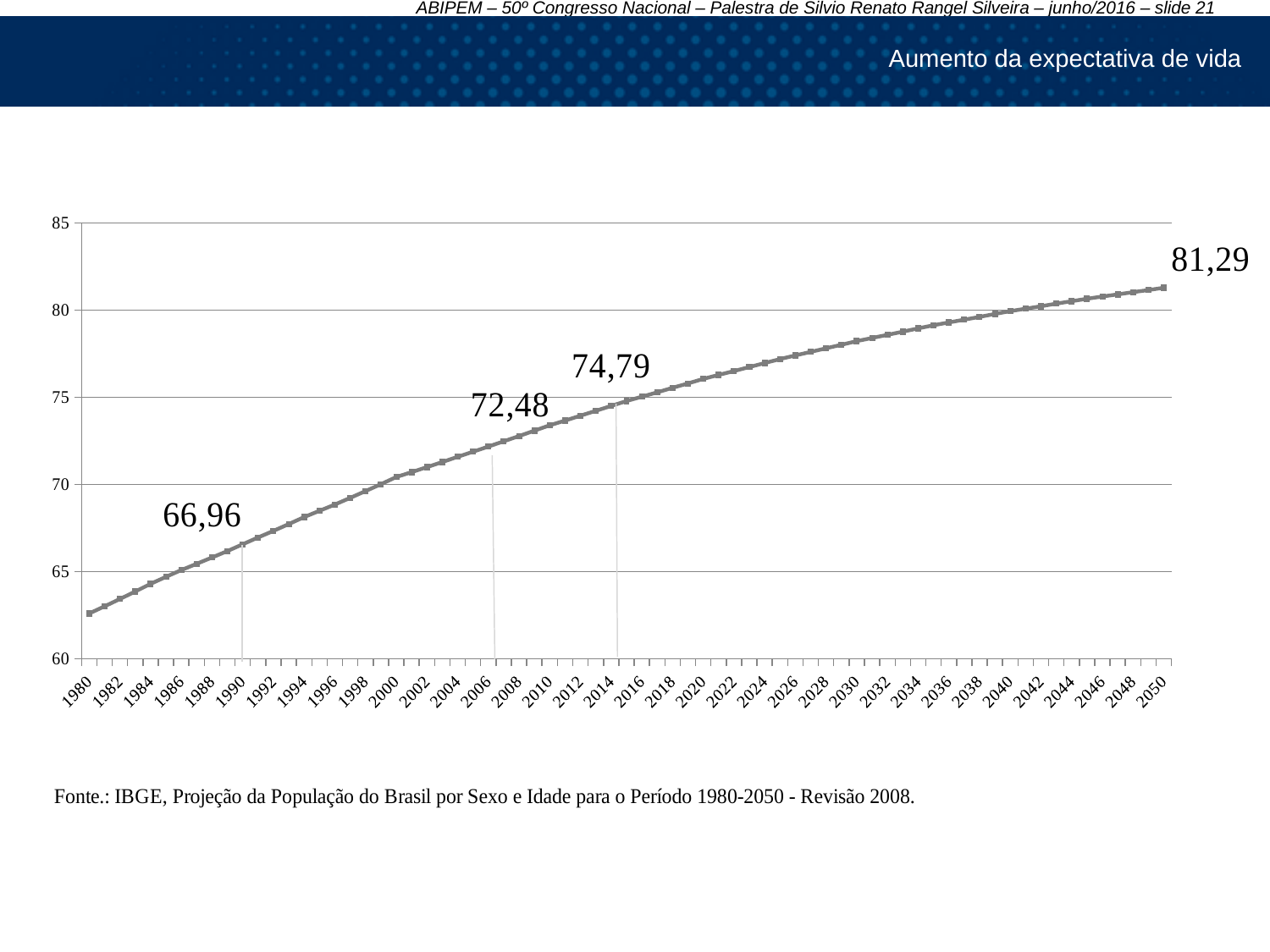
Is the value for 2030 greater or less than 75? greater Do the values rise or fall from 1980 to 2050? rise What kind of chart is shown on the slide? line chart What is the title shown at the top of the slide for this chart? Aumento da expectativa de vida What value is labelled at the end of the line, for the year 2050? 81,29 Is the value for 1980 greater or less than 65? less